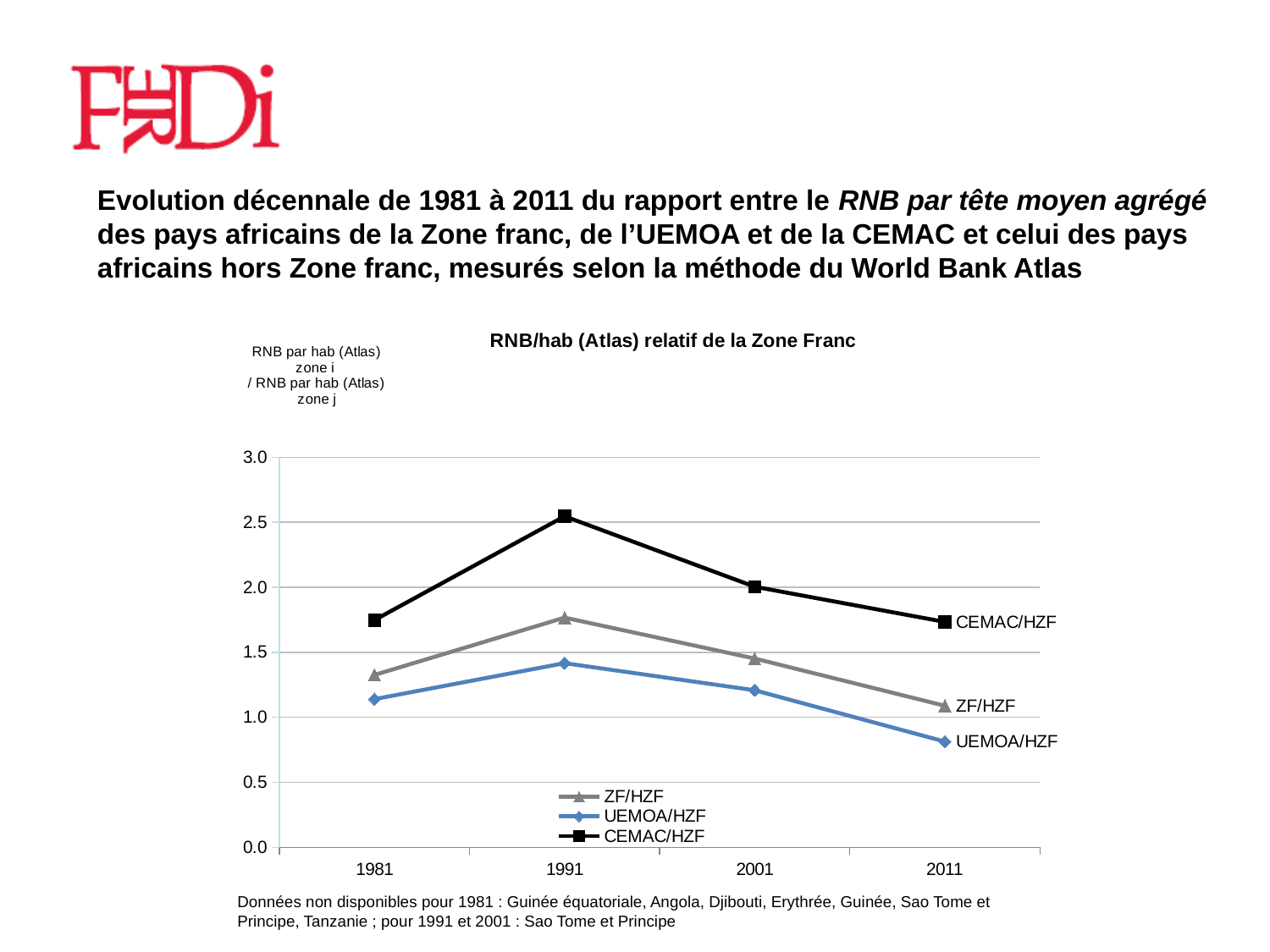
Is the value for CEMAC/HZF in 1991 greater or less than 2.0? greater How many series does the chart legend list? 3 What is the title of the chart? RNB/hab (Atlas) relatif de la Zone Franc Is the value for UEMOA/HZF in 2011 greater or less than 1.0? less Is the value for CEMAC/HZF in 1981 greater or less than 1.5? greater Which series has the highest value in 2001: CEMAC/HZF or UEMOA/HZF? CEMAC/HZF How many years are plotted along the x axis of the chart? 4 In which year does the UEMOA/HZF series reach its lowest value? 2011 What kind of chart is shown on the slide? line chart Do the values of the ZF/HZF series rise or fall from 1991 to 2011? fall In which year does the CEMAC/HZF series reach its highest value? 1991